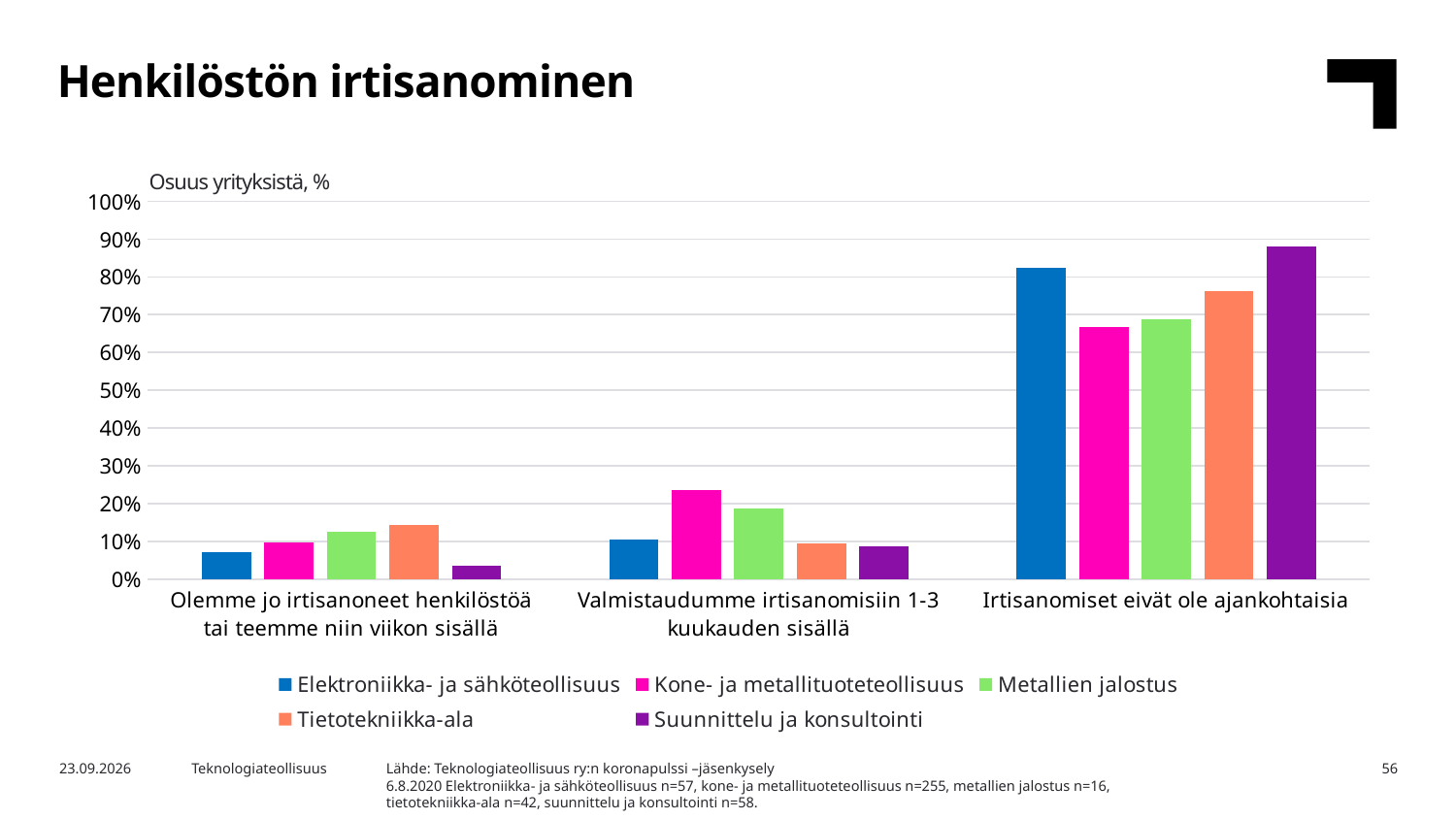
How many categories are shown on the x axis? 3 Is the value for Kone- ja metallituoteteollisuus in 'Valmistaudumme irtisanomisiin 1-3 kuukauden sisällä' greater or less than 20%? greater In the category 'Valmistaudumme irtisanomisiin 1-3 kuukauden sisällä', which series has the highest value? Kone- ja metallituoteteollisuus In the category 'Olemme jo irtisanoneet henkilöstöä tai teemme niin viikon sisällä', which series has the lowest value? Suunnittelu ja konsultointi What colour represents Metallien jalostus in the chart? Green What kind of chart is shown on the slide? Bar chart In the category 'Irtisanomiset eivät ole ajankohtaisia', which is larger: Elektroniikka- ja sähköteollisuus or Tietotekniikka-ala? Elektroniikka- ja sähköteollisuus What is the label shown above the y axis of the chart? Osuus yrityksistä, % Is the value for Suunnittelu ja konsultointi in 'Irtisanomiset eivät ole ajankohtaisia' greater or less than 80%? greater In the category 'Irtisanomiset eivät ole ajankohtaisia', which series has the highest value? Suunnittelu ja konsultointi Is the value for Elektroniikka- ja sähköteollisuus in 'Olemme jo irtisanoneet henkilöstöä tai teemme niin viikon sisällä' greater or less than 10%? less How many series does the legend list? 5